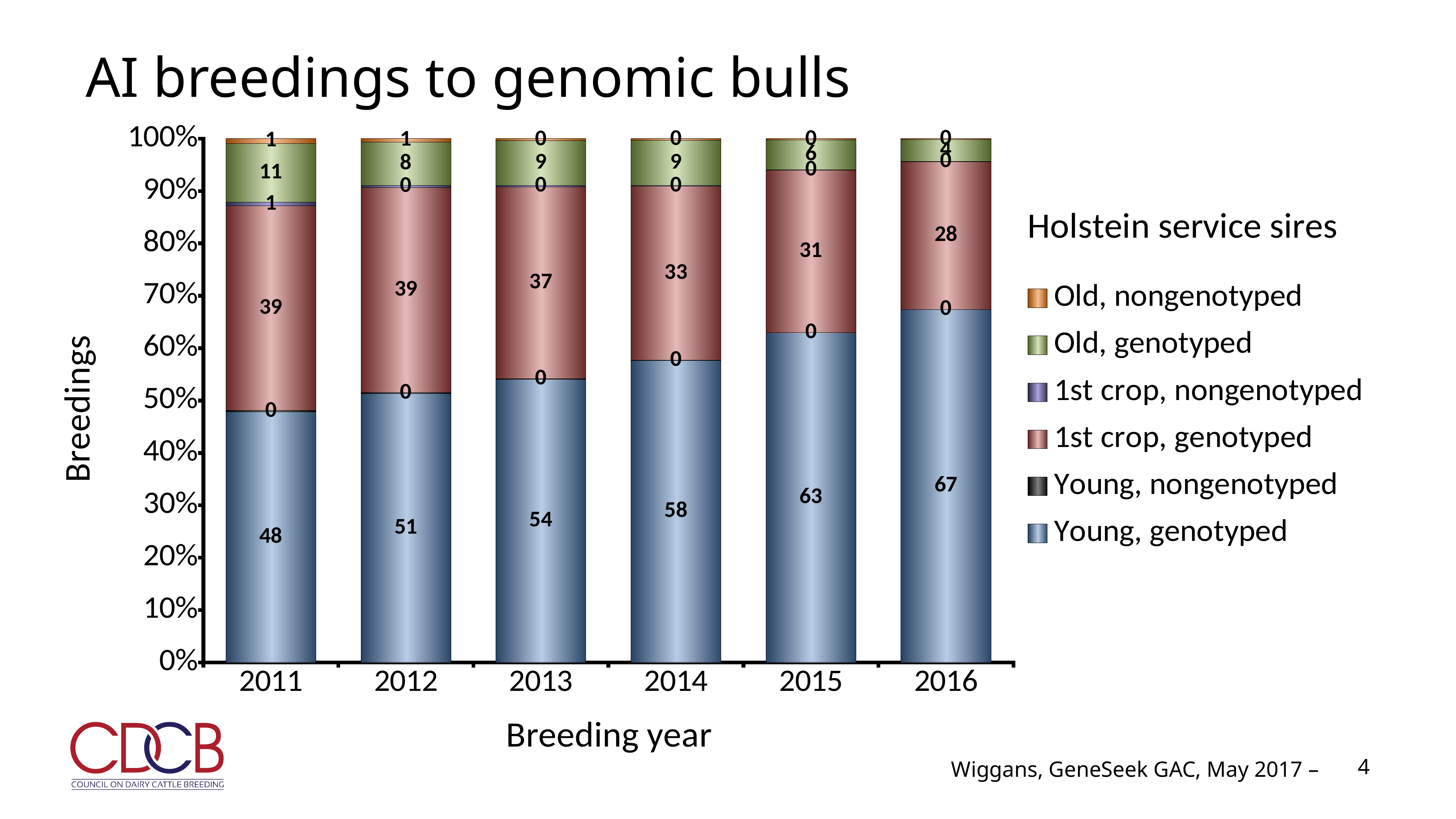
How many series does the legend list? 6 What is the value for 1st crop, genotyped in 2016? 28 What is the value for Old, genotyped in 2011? 11 What is the label of the x axis? Breeding year Which is larger, the 1st crop, genotyped value in 2013 or in 2015? 2013 What type of chart is shown on the slide? stacked bar chart How many breeding years are shown on the x axis? 6 In which breeding year is the Young, genotyped value highest? 2016 What is the value for Young, genotyped in 2014? 58 What is the difference between the Young, genotyped values for 2016 and 2011? 19 In which breeding year is the Old, genotyped value lowest? 2016 Does the Young, genotyped value rise or fall from 2011 to 2016? rise